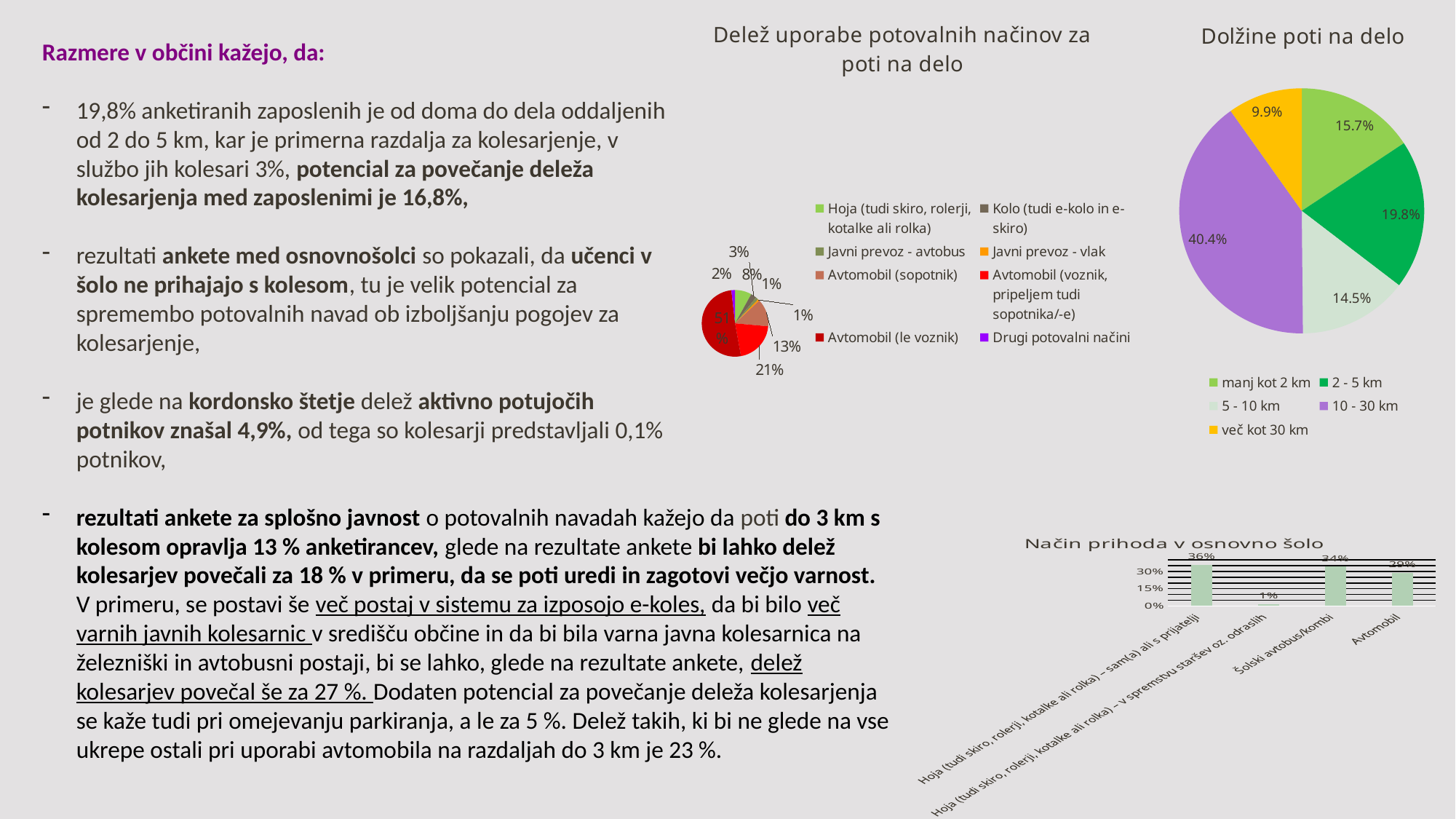
In the 'Način prihoda v osnovno šolo' chart, which category has the lowest value? Hoja (tudi skiro, rolerji, kotalke ali rolka) – v spremstvu staršev oz. odraslih In the 'Način prihoda v osnovno šolo' chart, what is the value for 'Avtomobil'? 29% What kind of chart is 'Način prihoda v osnovno šolo'? bar chart In the 'Dolžine poti na delo' pie chart, what is the difference between the shares for 'manj kot 2 km' and '5 - 10 km'? 1.2% In the 'Dolžine poti na delo' pie chart, how many distance categories does the legend list? 5 In the 'Dolžine poti na delo' pie chart, what share of commutes are 2 - 5 km? 19.8% How many travel modes does the legend of the 'Delež uporabe potovalnih načinov za poti na delo' chart list? 8 In the 'Delež uporabe potovalnih načinov za poti na delo' pie chart, what is the share of 'Avtomobil (le voznik)'? 51% In the 'Dolžine poti na delo' pie chart, what share of commutes are 10 - 30 km? 40.4% In the 'Delež uporabe potovalnih načinov za poti na delo' pie chart, which travel mode has the largest share? Avtomobil (le voznik) In the 'Dolžine poti na delo' pie chart, which distance category has the smallest share? več kot 30 km In the 'Dolžine poti na delo' pie chart, which distance category has the largest share? 10 - 30 km